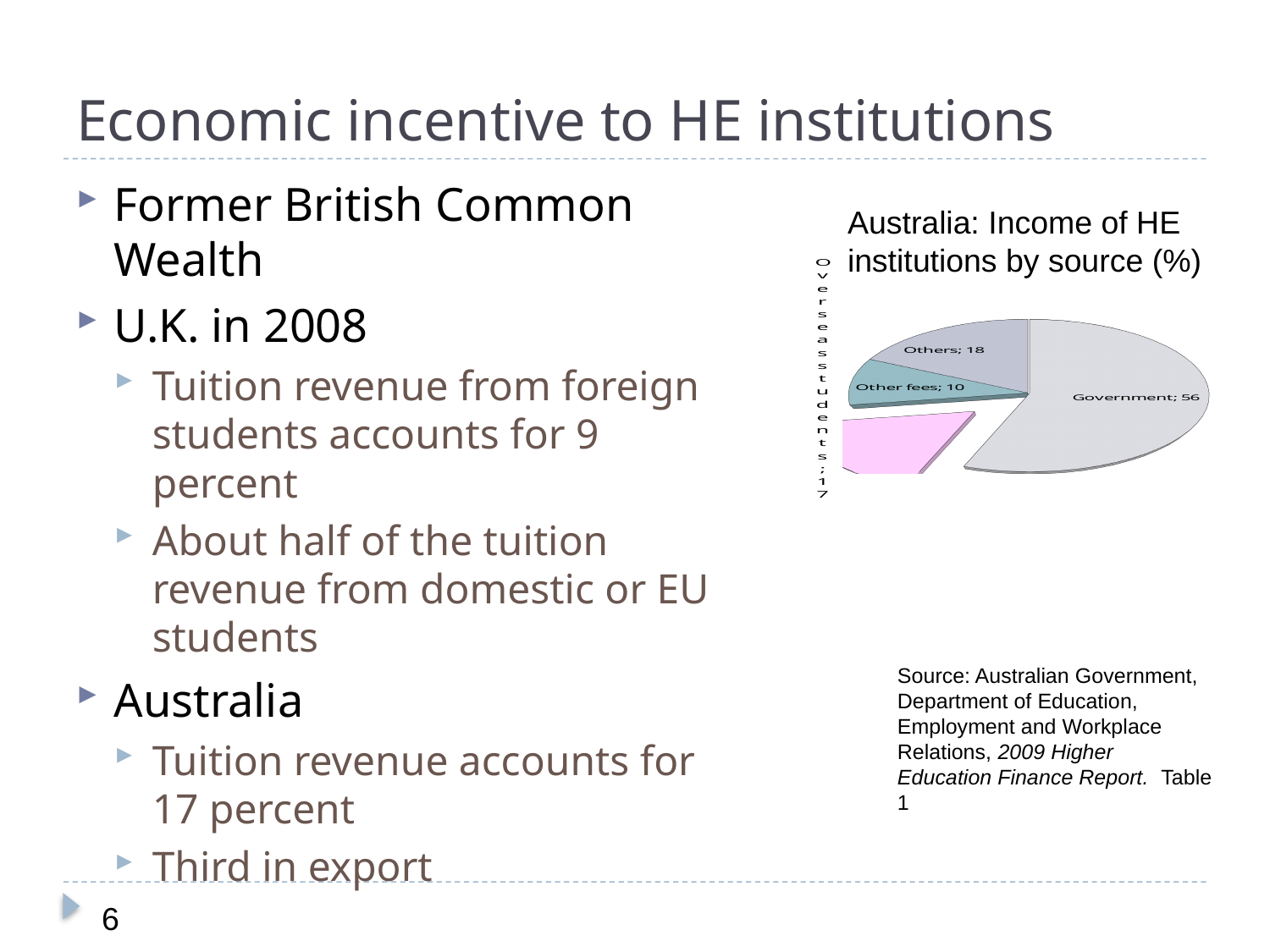
What is the value for Government in the pie chart? 56 What is the difference between the Government value and the Others value? 38 How many slices does the pie chart have? 4 What is the title of the chart? Australia: Income of HE institutions by source (%) Which is larger, the value for Others or the value for Overseas students? Others Which source has the largest slice of the pie? Government What is the value for Other fees in the pie chart? 10 What is the value for Overseas students in the pie chart? 17 What is the difference between the Overseas students value and the Other fees value? 7 What is the value for Others in the pie chart? 18 Which source has the smallest slice of the pie? Other fees What kind of chart is shown on the slide? Pie chart